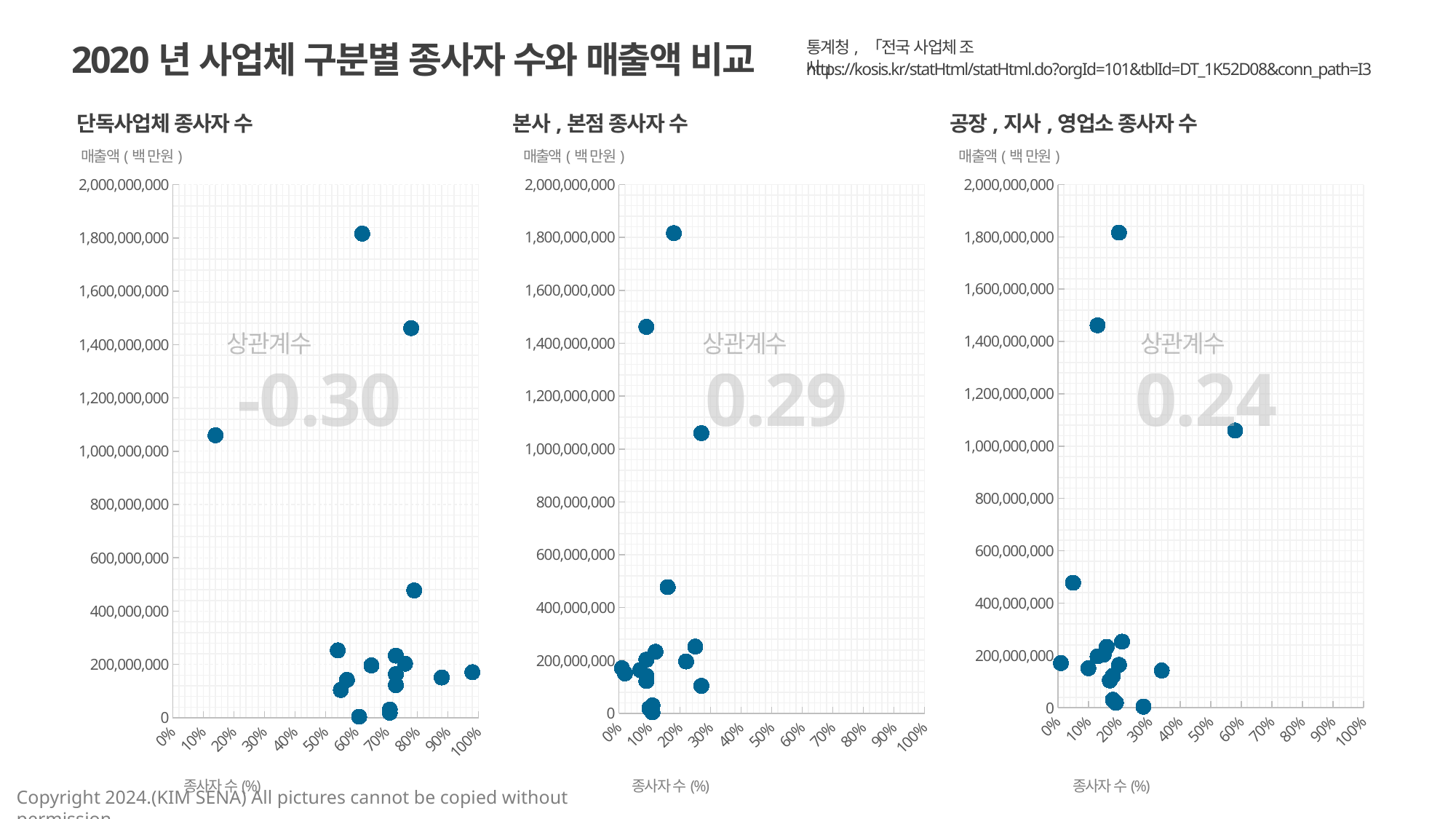
In the chart titled 본사, 본점 종사자 수, is the 매출액 of the highest point greater or less than 1,600,000,000? greater In the chart titled 공장, 지사, 영업소 종사자 수, is the 매출액 of the point at about 5% 종사자 수 greater or less than 600,000,000? less In the chart titled 본사, 본점 종사자 수, is the 매출액 of the point at about 5% 종사자 수 greater or less than 400,000,000? less How many charts are shown on the slide? 3 What kind of chart is used in the three charts on this slide? scatter chart In the chart titled 본사, 본점 종사자 수, what correlation coefficient (상관계수) is printed on the chart? 0.29 In the chart titled 단독사업체 종사자 수, what correlation coefficient (상관계수) is printed on the chart? -0.30